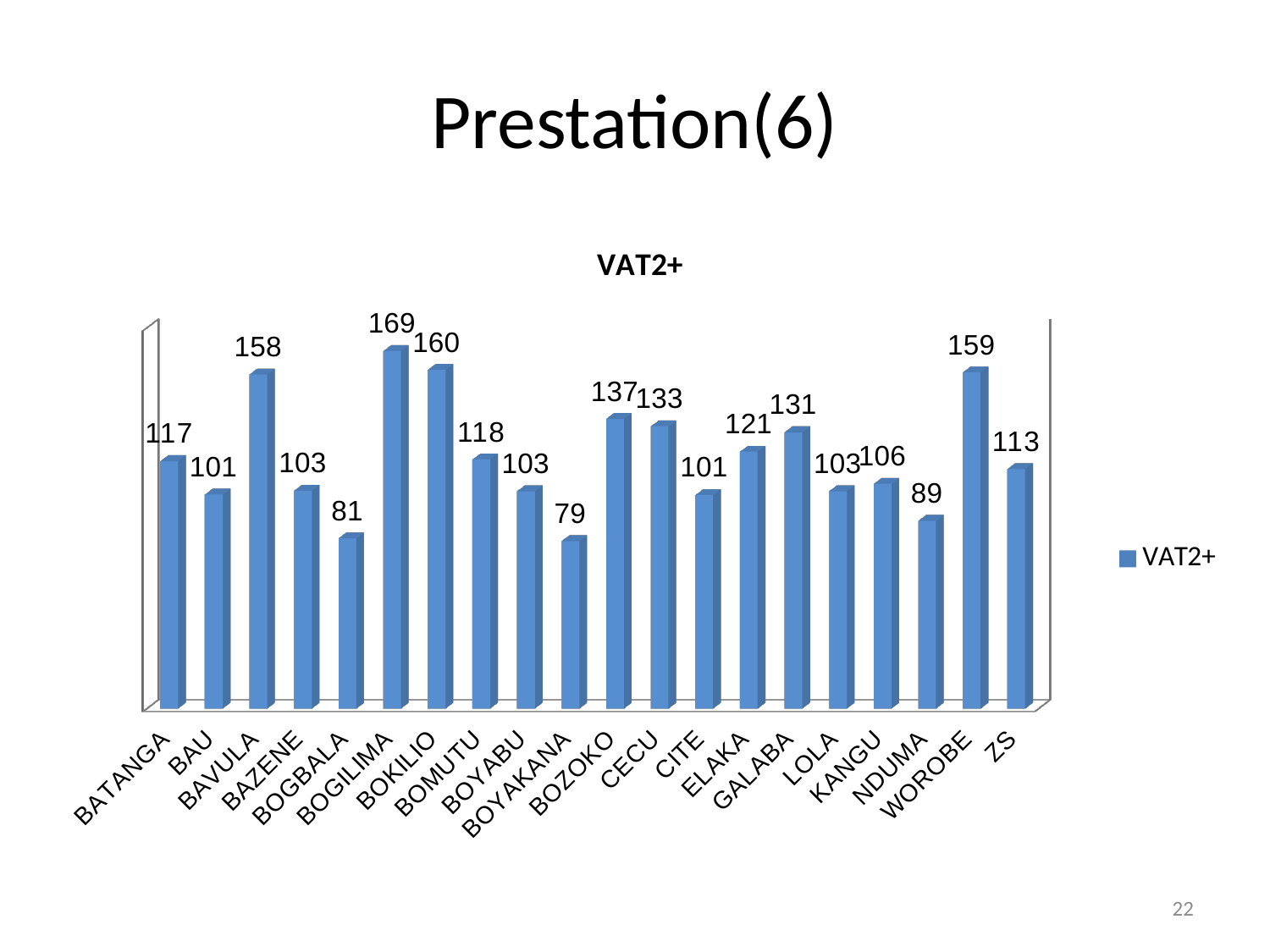
What is the difference between the VAT2+ values for BOZOKO and CECU? 4 Which category has the lowest VAT2+ value? BOYAKANA How many series does the legend list? 1 What is the VAT2+ value for NDUMA? 89 What kind of chart is shown on the slide? Bar chart Which category has the highest VAT2+ value? BOGILIMA What is the VAT2+ value for BOGILIMA? 169 What is the difference between the VAT2+ values for BOGILIMA and BOYAKANA? 90 How many categories are shown on the x axis of the chart? 20 Which has a larger VAT2+ value, ELAKA or GALABA? GALABA Which has a larger VAT2+ value, BAVULA or BOKILIO? BOKILIO What is the VAT2+ value for WOROBE? 159